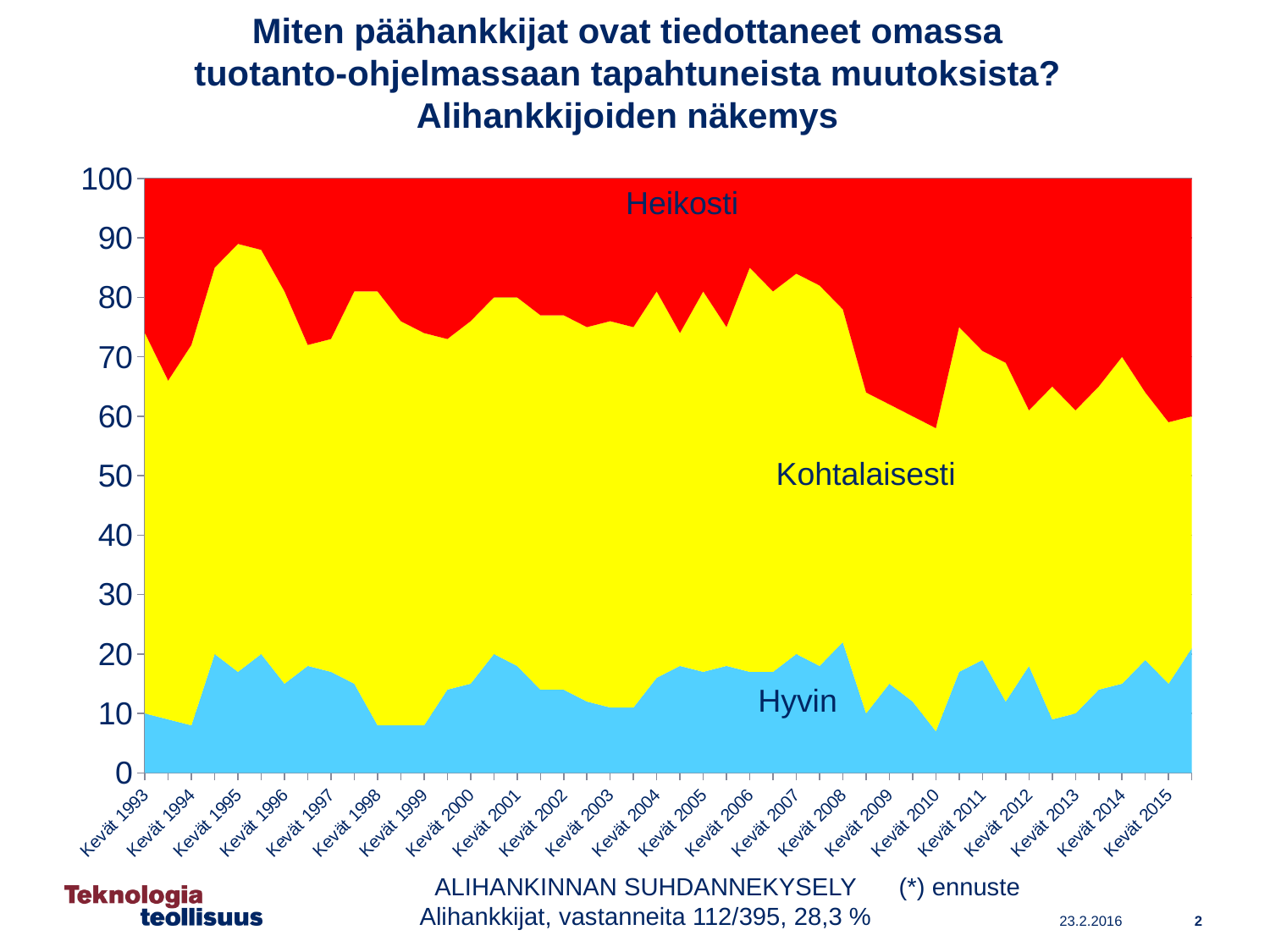
Is the value for 'Hyvin' at Kevät 2015 greater or less than 10? greater Is the 'Hyvin' value larger at Kevät 2015 or at Kevät 2010? Kevät 2015 Does the top boundary of the 'Kohtalaisesti' area rise or fall from Kevät 2007 to Kevät 2010? Fall How many 'Kevät' year labels are shown on the x axis? 23 What kind of chart is shown on the slide? Stacked area chart Is the top of the 'Kohtalaisesti' area at Kevät 1995 greater or less than 80? greater Is the top of the 'Kohtalaisesti' area at Kevät 2010 greater or less than 70? less Which series occupies the largest share of the chart area overall? Kohtalaisesti How many series are labelled in the chart? 3 Which series is plotted at the bottom of the stacked area chart? Hyvin Which colour represents the 'Heikosti' series? Red What is the first x-axis label on the chart? Kevät 1993